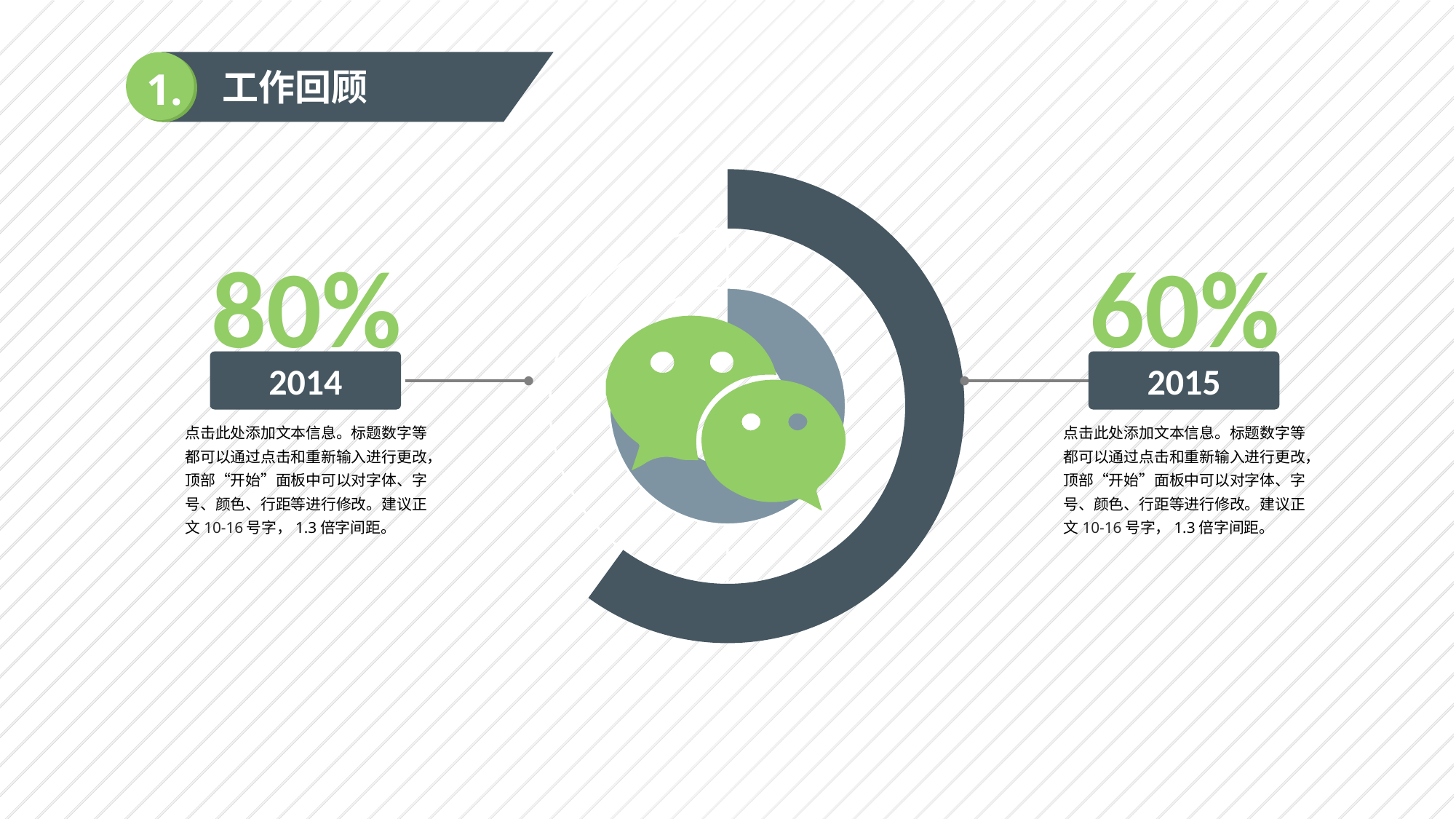
What is the section title shown at the top of the slide? 工作回顾 Which year has the lowest percentage shown? 2015 Is the value for 2015 greater or less than 70%? less What is the difference between the 2014 and 2015 percentages? 20% What percentage is shown for 2015? 60% What colour are the percentage figures printed in? green Which year shows the higher percentage, 2014 or 2015? 2014 How many years are labelled on the slide? 2 What percentage is shown for 2014? 80% Does the percentage rise or fall from 2014 to 2015? fall